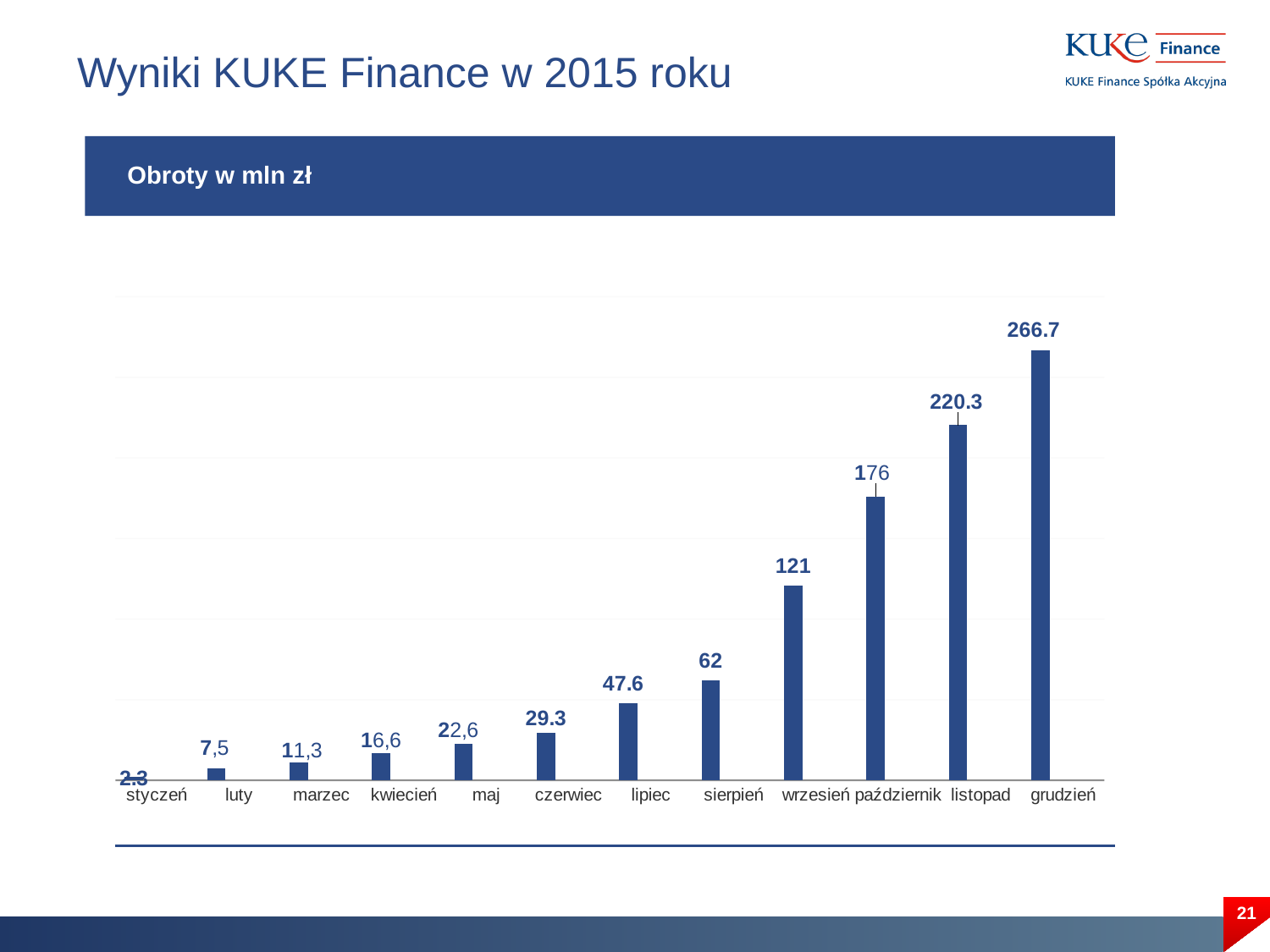
Which is larger, the value for lipiec or the value for sierpień? sierpień What kind of chart is shown on the slide? bar chart What is the value for lipiec? 47.6 How many months are shown on the x axis? 12 What is the difference between the values for wrzesień and sierpień? 59 What is the value for wrzesień? 121 Which month has the highest value? grudzień What is the value for maj? 22,6 Which month has the lowest value? styczeń Do the values rise or fall from styczeń to grudzień? rise What is the value for grudzień? 266.7 What is the difference between the values for grudzień and listopad? 46.4